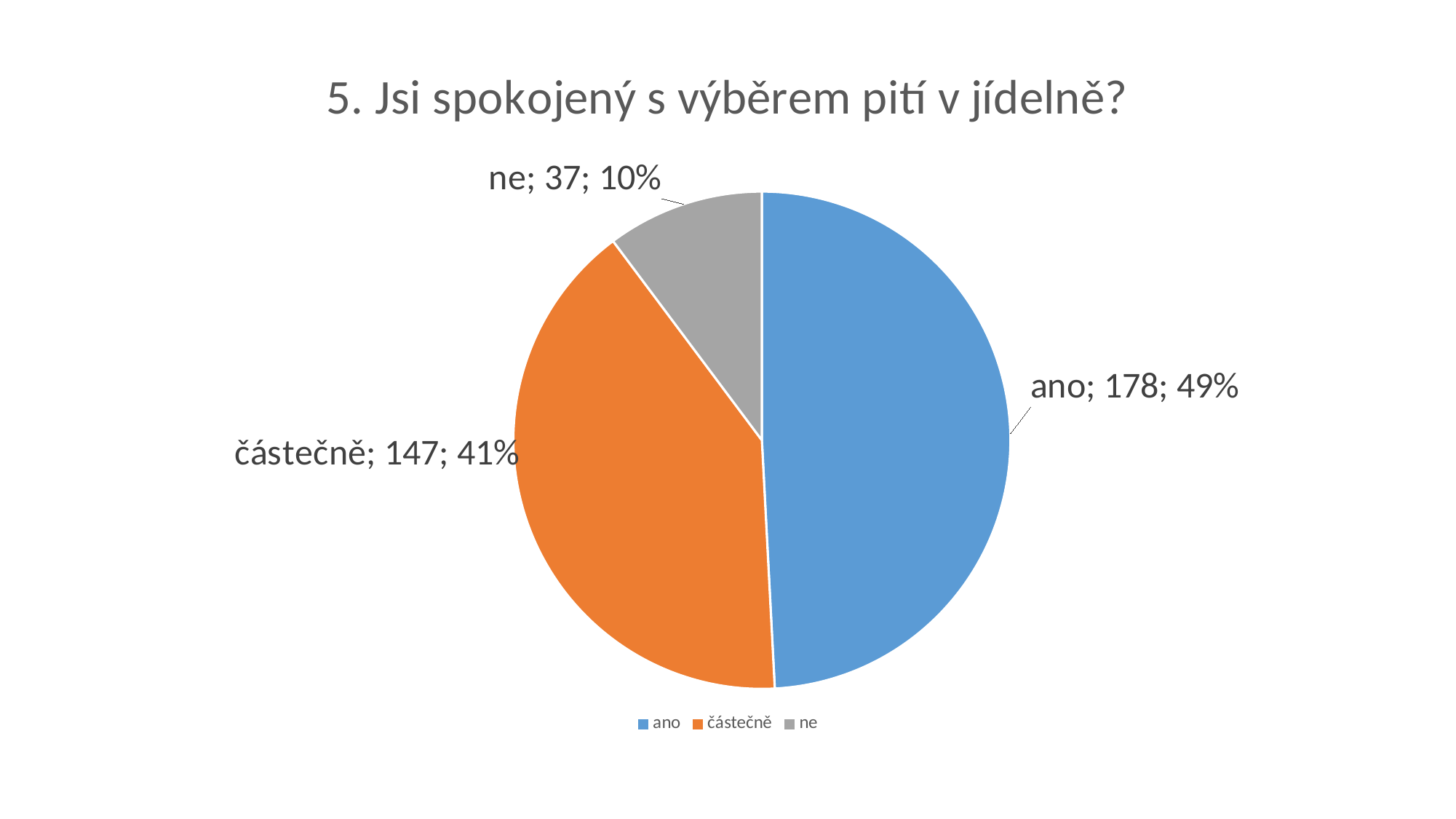
Which category has the smallest slice? ne How many respondents answered "ne"? 37 What is the difference between the number of "ano" and "částečně" responses? 31 Which category has the largest slice? ano What share of the pie does the "ne" slice represent? 10% How many respondents answered "ano"? 178 What is the title of the chart? 5. Jsi spokojený s výběrem pití v jídelně? Which is larger, the value for "částečně" or the value for "ne"? částečně How many respondents answered "částečně"? 147 What kind of chart is shown on the slide? pie chart What share of the pie does the "ano" slice represent? 49% How many categories does the legend list? 3